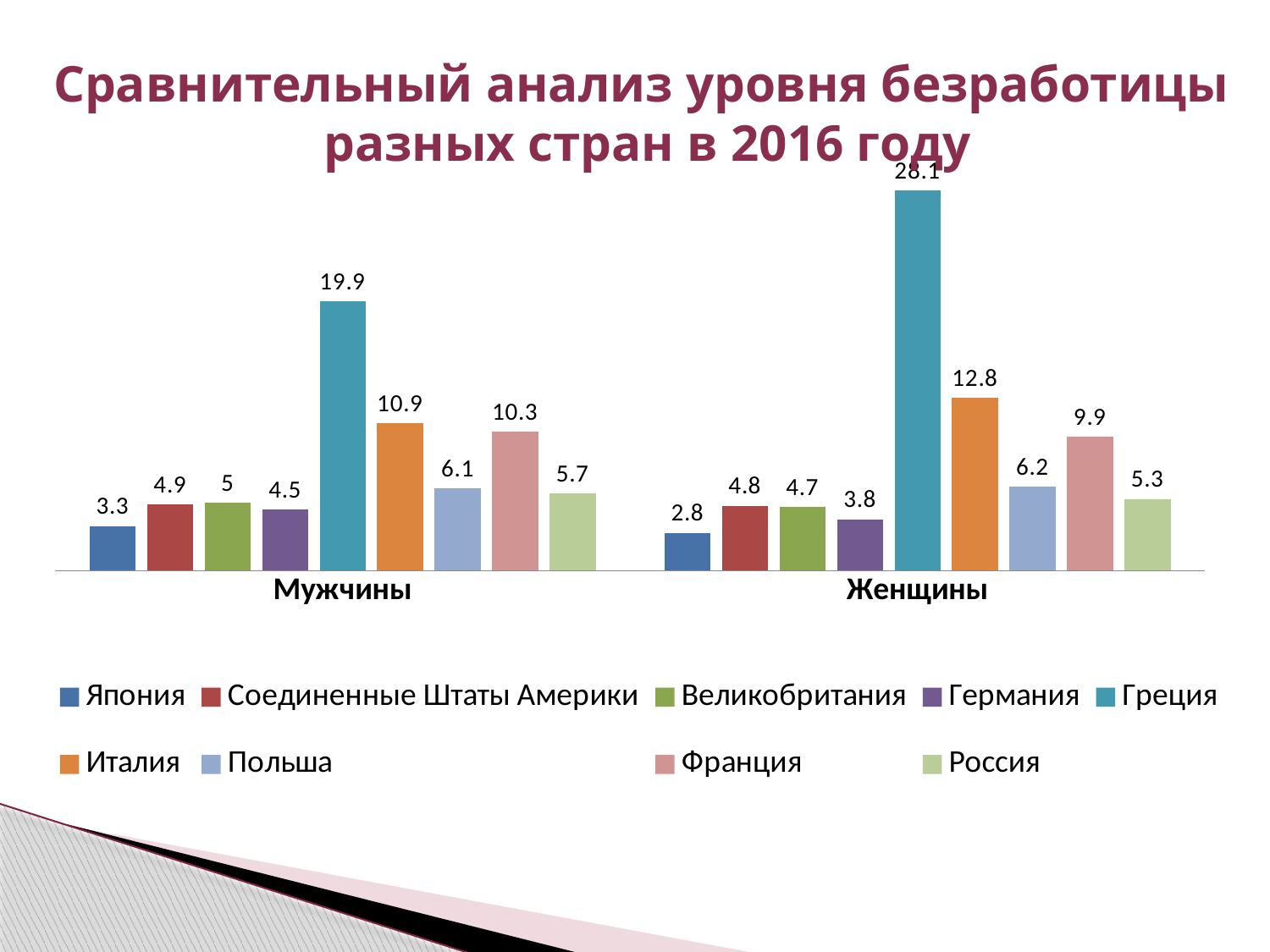
Сколько категорий показано на оси X диаграммы? 2 Какова разница между значениями Италии и Франции в категории «Мужчины»? 0.6 Какое значение уровня безработицы для Греции в категории «Мужчины»? 19.9 На сколько значение для Греции в категории «Женщины» больше значения для Греции в категории «Мужчины»? 8.2 Какого типа эта диаграмма? Столбчатая (bar chart) Сколько рядов (стран) перечислено в легенде диаграммы? 9 Какое значение показано для Японии в категории «Женщины»? 2.8 Что больше: значение для Польши в категории «Мужчины» или значение для России в категории «Мужчины»? Польша Какая страна имеет самый высокий уровень безработицы в категории «Женщины»? Греция Какое значение уровня безработицы для Италии в категории «Женщины»? 12.8 Какая страна имеет самый низкий уровень безработицы в категории «Мужчины»? Япония Каким цветом на диаграмме обозначена Греция? Бирюзовым (сине-зелёным)